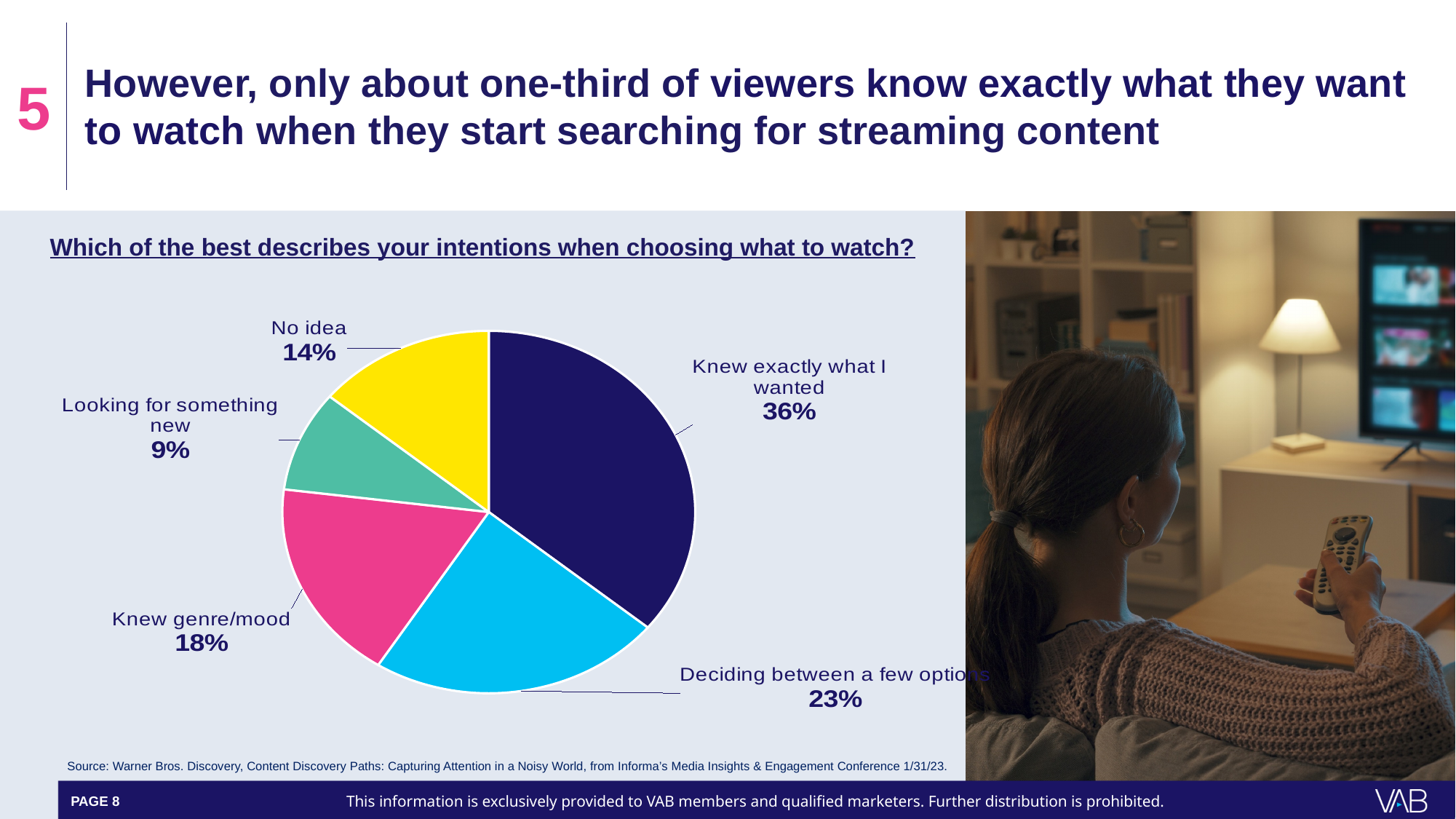
What is the difference in percentage points between 'Knew exactly what I wanted' and 'Deciding between a few options'? 13 percentage points What percentage of viewers were deciding between a few options? 23% What percentage of viewers knew the genre/mood? 18% Which category has the largest share of the pie? Knew exactly what I wanted What kind of chart is shown on the slide? Pie chart What percentage of viewers had no idea what to watch? 14% What is the title of the chart? Which of the best describes your intentions when choosing what to watch? What percentage of viewers were looking for something new? 9% How many categories are shown in the pie chart? 5 What percentage of viewers said they knew exactly what they wanted? 36% Which is larger: the share for 'Knew genre/mood' or the share for 'No idea'? Knew genre/mood Which category has the smallest share of the pie? Looking for something new